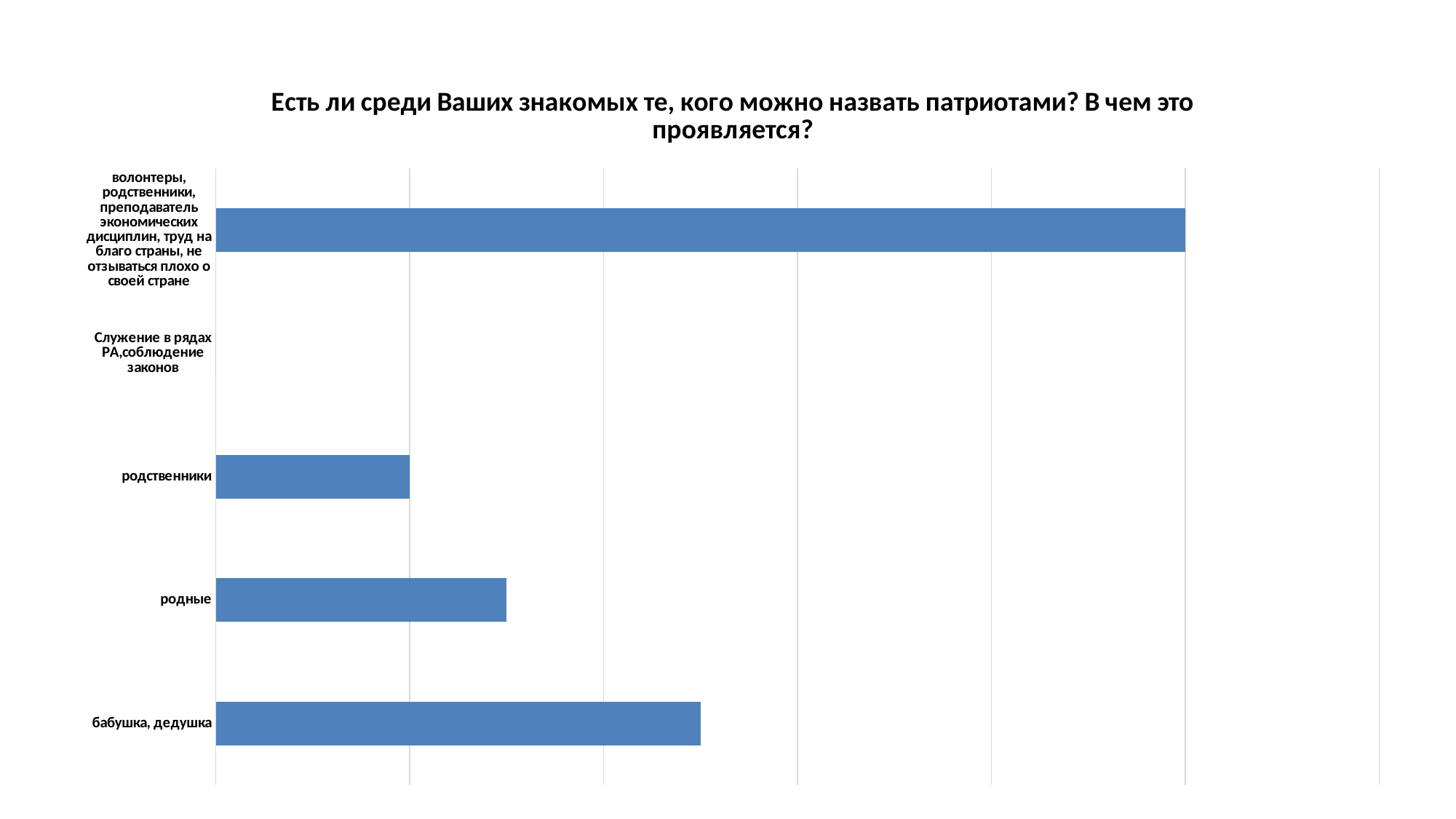
Which category has the lowest value on the chart? Служение в рядах РА,соблюдение законов How many categories are listed on the chart? 5 Which is larger: the value for 'бабушка, дедушка' or the value for 'родные'? бабушка, дедушка Which category has the longest bar on the chart? волонтеры, родственники, преподаватель экономических дисциплин, труд на благо страны, не отзываться плохо о своей стране Which category has no visible bar on the chart? Служение в рядах РА,соблюдение законов What is the title of the chart? Есть ли среди Ваших знакомых те, кого можно назвать патриотами? В чем это проявляется? Which is larger: the value for 'родные' or the value for 'родственники'? родные Which is larger: the value for 'родственники' or the value for 'бабушка, дедушка'? бабушка, дедушка Among the categories with a visible bar, which has the shortest bar? родственники What kind of chart is shown on the slide? bar chart